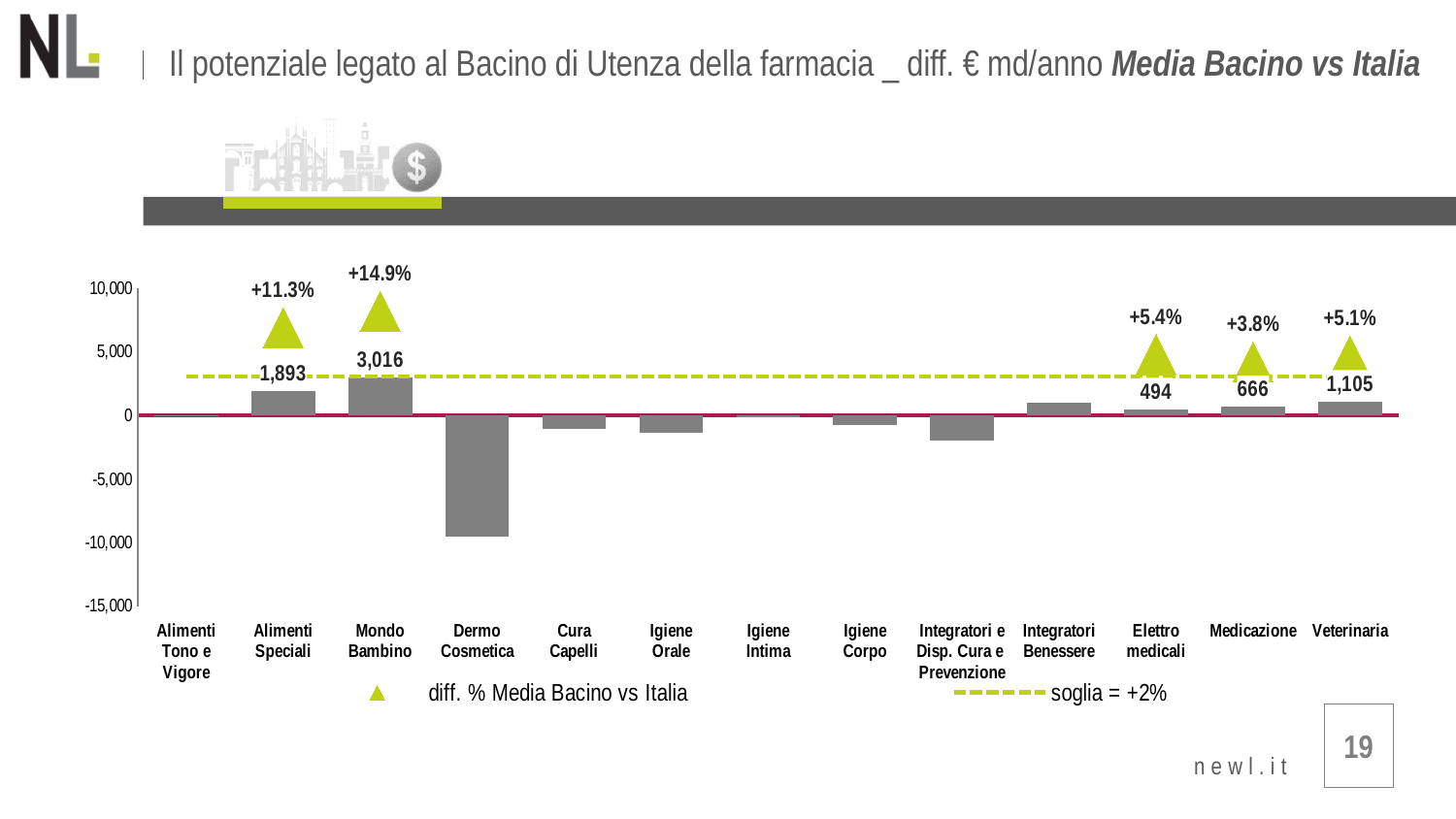
What is the value for Mondo Bambino? 3,016 Is the value for Dermo Cosmetica greater or less than -5,000? less How many categories are shown on the x axis? 13 What is the value for Veterinaria? 1,105 Which category has the highest value? Mondo Bambino Which category has the lowest value? Dermo Cosmetica What is the value for Alimenti Speciali? 1,893 What threshold value does the dashed line in the legend represent? soglia = +2% What percentage difference is shown above Mondo Bambino? +14.9% Which is larger, the value for Medicazione or the value for Elettro medicali? Medicazione What percentage difference is shown above Medicazione? +3.8% What is the difference between the values for Mondo Bambino and Alimenti Speciali? 1,123